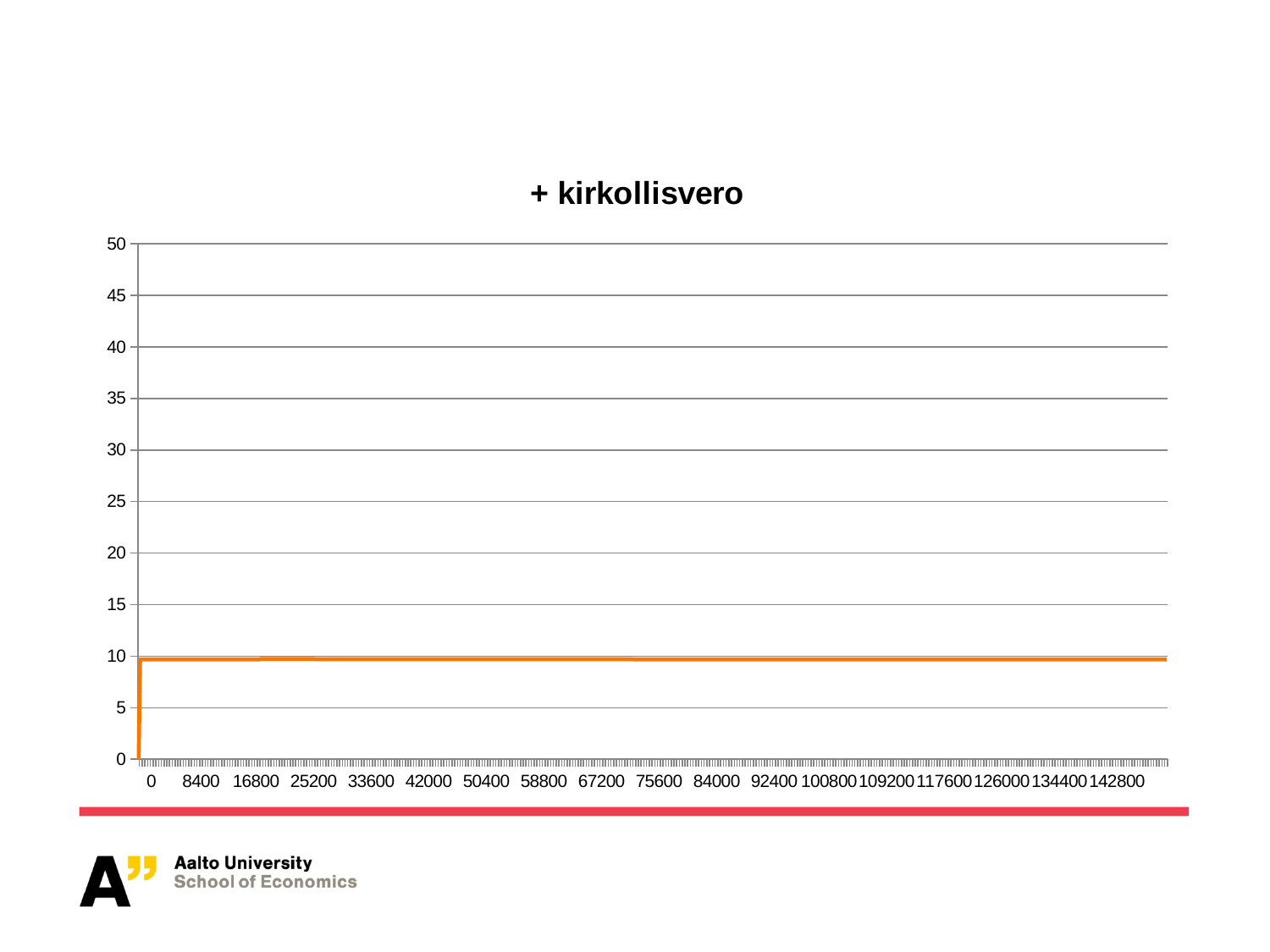
Is the value for 42000 greater or less than 5? greater How many labelled tick values are shown on the x axis? 18 What is the highest value shown on the y axis? 50 What kind of chart is shown on the slide? line chart What colour is the plotted line? orange What is the title of the chart? + kirkollisvero After the initial jump at 0, does the line rise, fall or stay flat along the x axis? stay flat Is the value for 142800 greater or less than 20? less Is the value for 16800 greater or less than 25? less What is the last labelled value on the x axis? 142800 What is the step between consecutive y-axis labels? 5